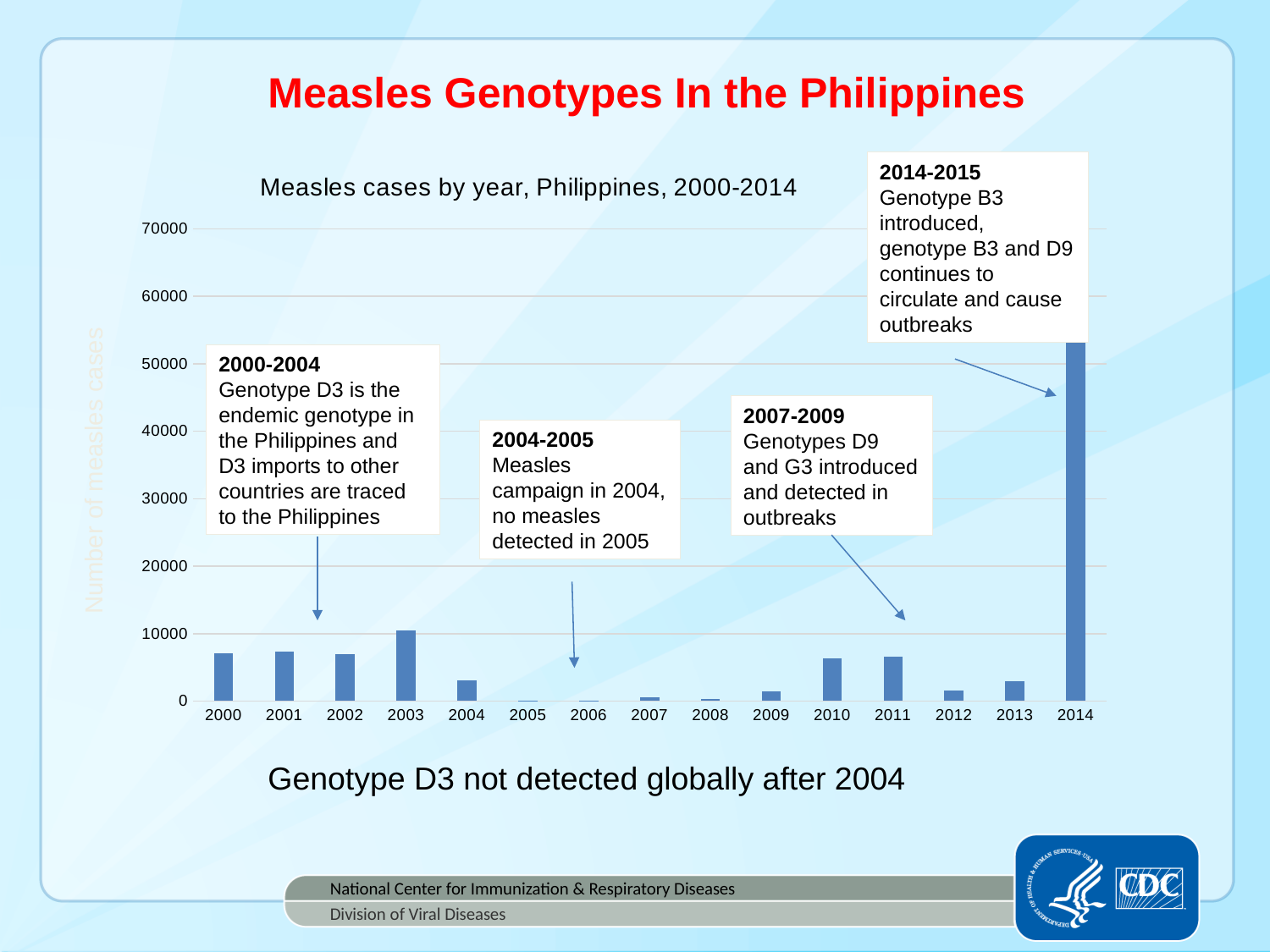
Is the value for 2004 greater or less than 10000? less Is the value for 2014 greater or less than 50000? greater What is the label of the y axis of the chart? Number of measles cases Do the values rise or fall from 2003 to 2006? fall Which year has more measles cases, 2003 or 2004? 2003 Which year has the highest number of measles cases? 2014 Which year has more measles cases, 2000 or 2014? 2014 What kind of chart is shown on the slide? bar chart Is the value for 2000 greater or less than 10000? less How many years are plotted on the x axis of the chart? 15 Which year has more measles cases, 2010 or 2012? 2010 What is the title of the chart? Measles cases by year, Philippines, 2000-2014